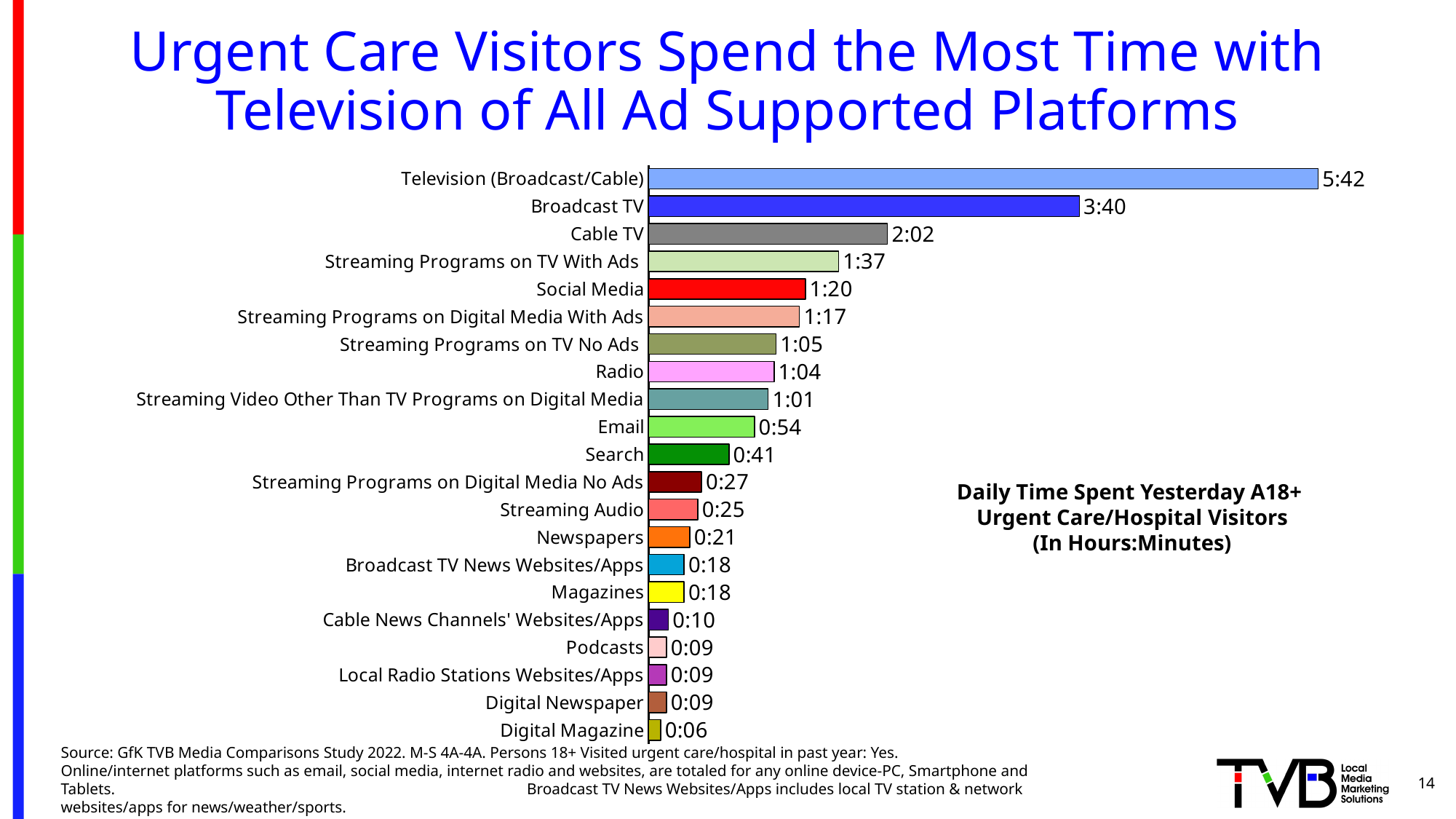
How many platforms are shown in the chart? 21 What is the difference in daily time spent between Television (Broadcast/Cable) and Broadcast TV? 2:02 Which has more daily time spent, Cable TV or Streaming Programs on TV With Ads? Cable TV What type of chart is shown on the slide? Bar chart Which platform has the lowest daily time spent? Digital Magazine What is the difference in daily time spent between Social Media and Email? 0:26 What is the daily time spent with Digital Magazine? 0:06 Which platform has the highest daily time spent? Television (Broadcast/Cable) What is the daily time spent with Social Media? 1:20 What is the daily time spent with Radio? 1:04 What is the daily time spent with Television (Broadcast/Cable)? 5:42 In what units are the values in the chart expressed, according to the chart's label? Hours:Minutes